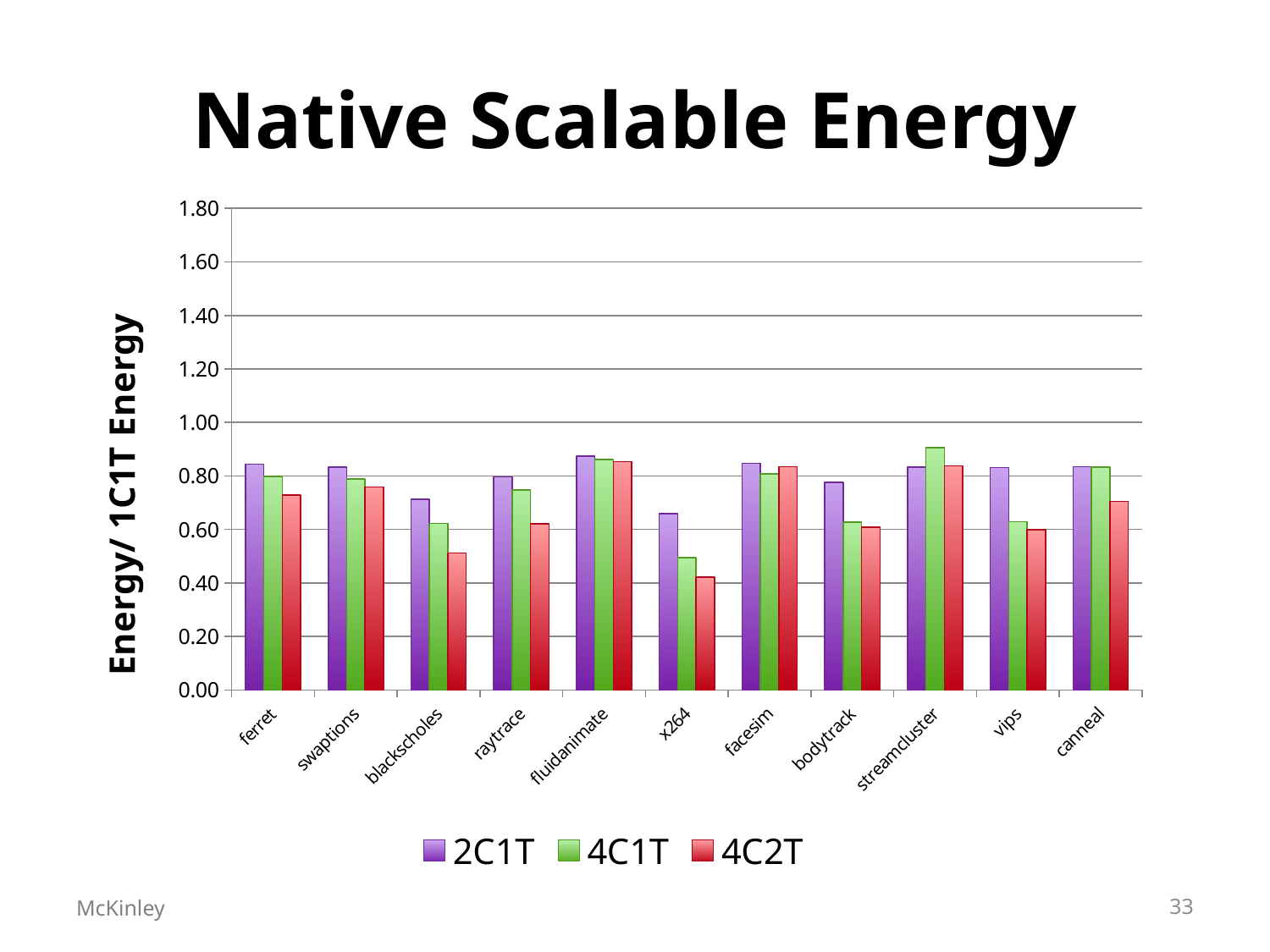
Is the 4C2T value for canneal greater or less than 0.80? less Which benchmark has the lowest 2C1T value? x264 How many benchmark categories are shown on the x axis? 11 Is the 4C2T value for x264 greater or less than 0.60? less Which benchmark has the highest 4C1T value? streamcluster How many series does the legend list? 3 Which benchmark has the lowest 4C2T value? x264 Is the 4C1T value for streamcluster greater or less than 0.80? greater For blackscholes, which is larger: the 4C1T value or the 4C2T value? 4C1T What kind of chart is shown on the slide? bar chart What is the label on the y axis? Energy/ 1C1T Energy What is the title of the chart? Native Scalable Energy